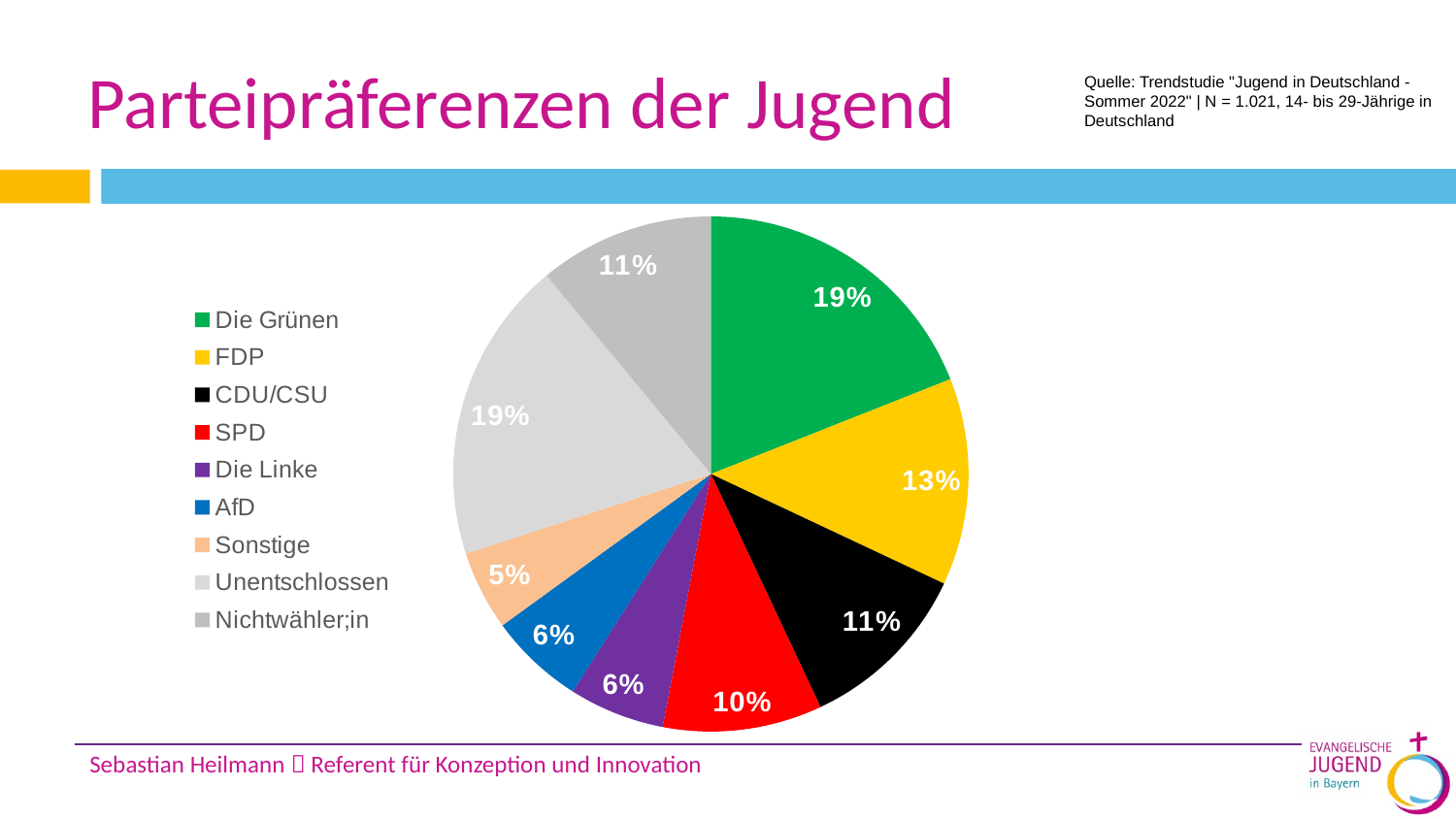
What percentage is shown for Unentschlossen? 19% What share of the pie does Die Grünen have? 19% What is the difference between the FDP share and the SPD share? 3% What percentage is shown for SPD? 10% How many categories does the pie chart show? 9 Which category has the smallest slice of the pie? Sonstige What percentage is shown for FDP? 13% What is the title of the slide containing the chart? Parteipräferenzen der Jugend What kind of chart is shown on the slide? Pie chart What share does Sonstige have? 5% What is the value for CDU/CSU? 11% Which is larger, the share for CDU/CSU or the share for AfD? CDU/CSU